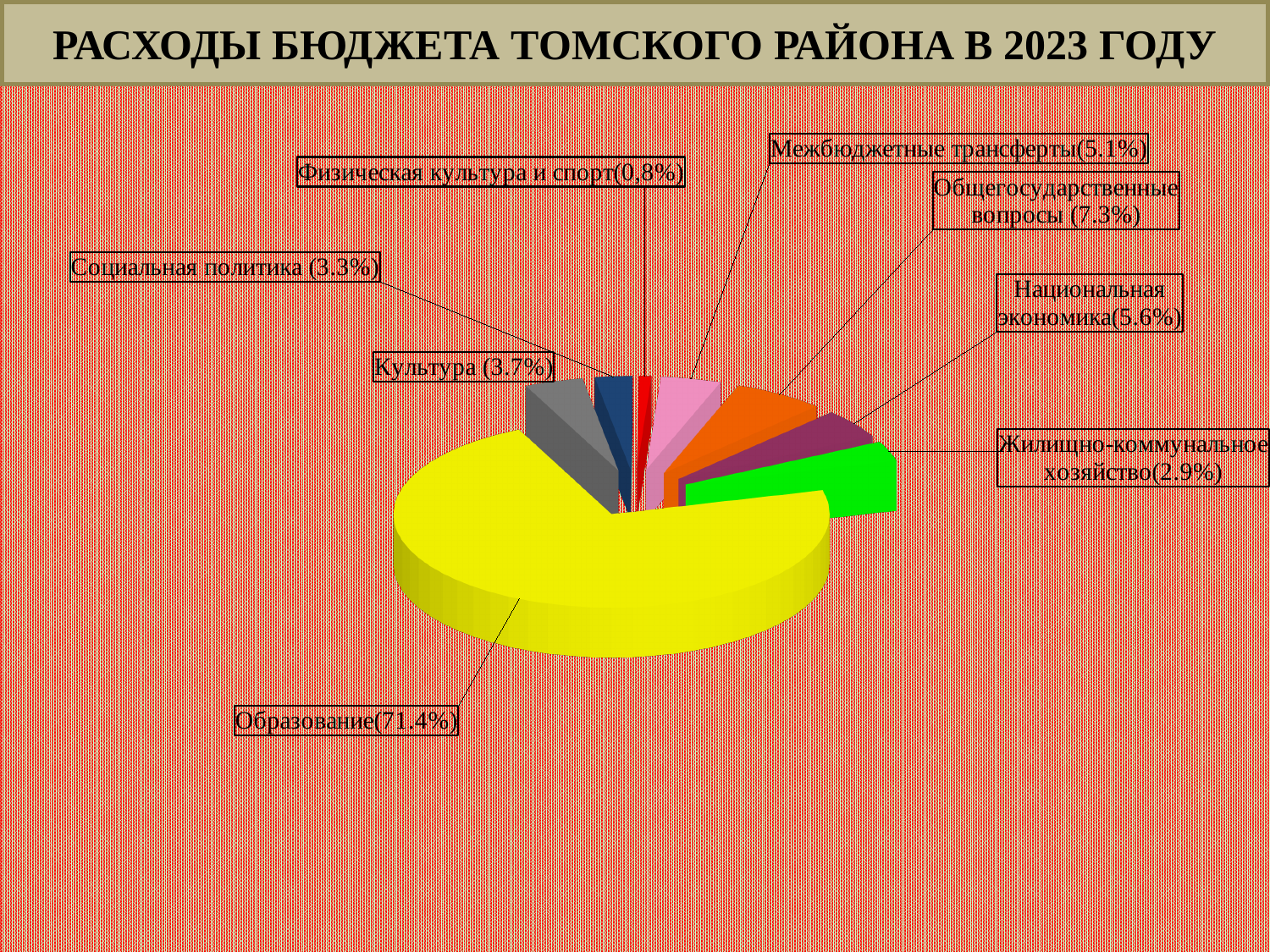
What is the value shown for Общегосударственные вопросы? 7.3% What share of the pie does Образование account for? 71.4% Which is larger, the value for Культура or the value for Социальная политика? Культура What is the value shown for Жилищно-коммунальное хозяйство? 2.9% What kind of chart is shown on the slide? Pie chart What is the title of the slide? РАСХОДЫ БЮДЖЕТА ТОМСКОГО РАЙОНА В 2023 ГОДУ Which category has the largest slice of the pie? Образование Which category has the smallest slice of the pie? Физическая культура и спорт What is the difference between the values for Общегосударственные вопросы and Национальная экономика? 1.7% What is the value shown for Национальная экономика? 5.6% What is the value shown for Межбюджетные трансферты? 5.1% How many categories are shown in the pie chart? 8